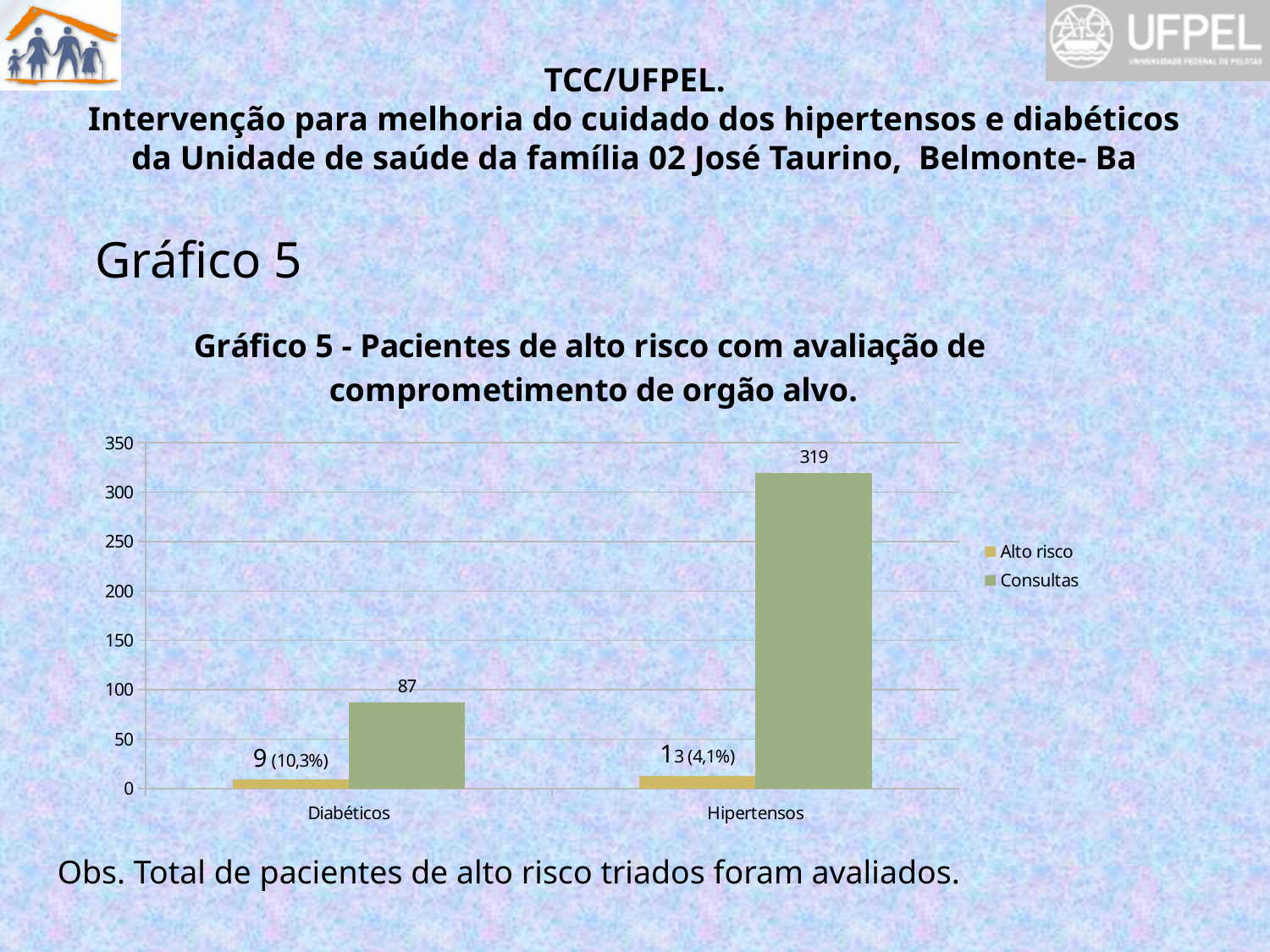
What is the difference between Consultas for Hipertensos and Consultas for Diabéticos? 232 How many series does the legend list? 2 What is the value of Alto risco for Hipertensos? 13 (4,1%) How many categories are shown on the x axis? 2 What is the title of the chart? Gráfico 5 - Pacientes de alto risco com avaliação de comprometimento de orgão alvo. What is the value of Alto risco for Diabéticos? 9 (10,3%) What is the value of Consultas for Diabéticos? 87 Which is larger: Consultas for Diabéticos or Alto risco for Hipertensos? Consultas for Diabéticos Is the Consultas value for Hipertensos greater or less than 300? greater What is the value of Consultas for Hipertensos? 319 Which category has the highest Consultas value? Hipertensos What type of chart is shown on the slide? bar chart